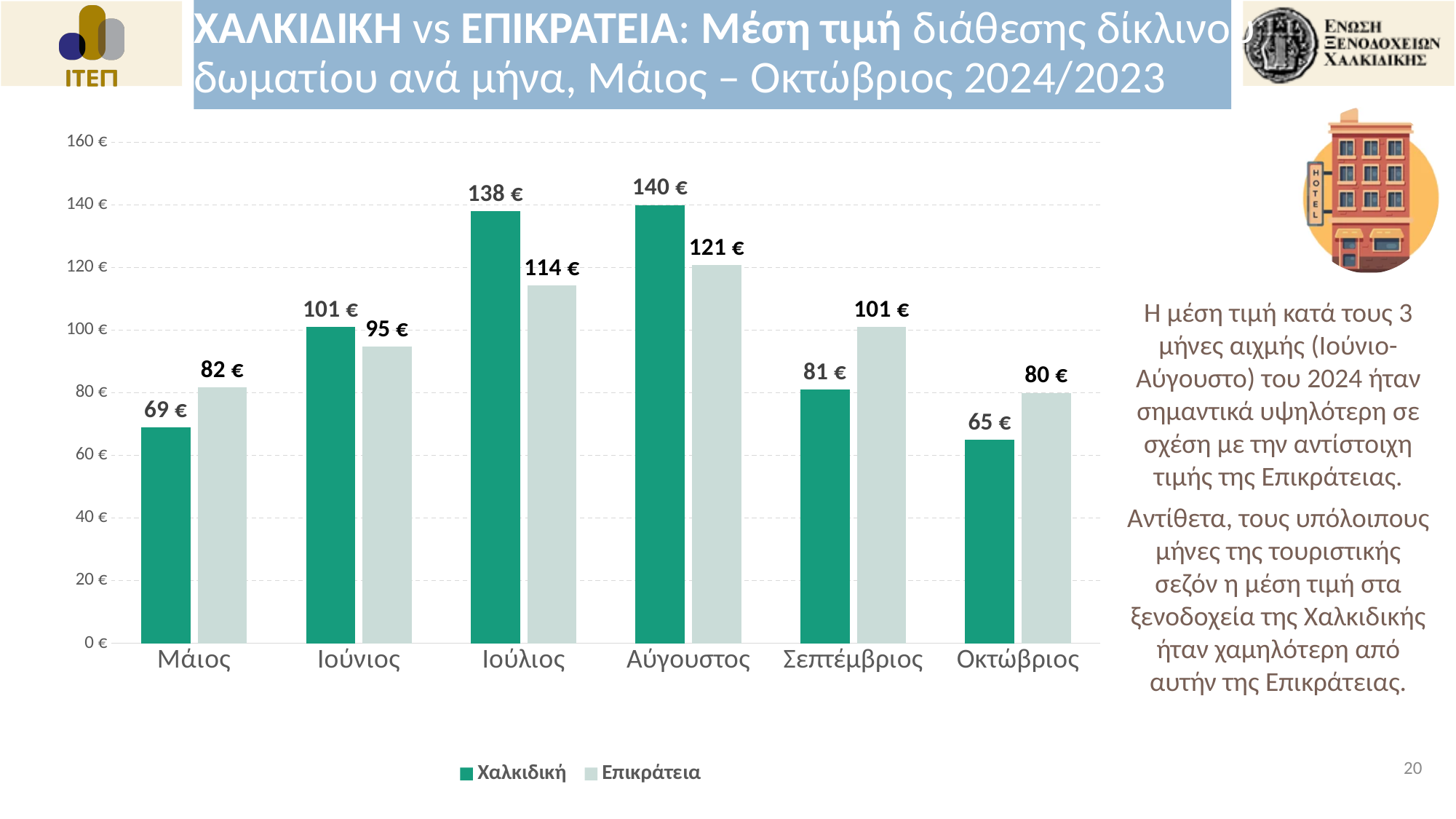
Which colour represents Χαλκιδική in the chart? green How many months are shown on the x axis? 6 Which month has the highest value for Χαλκιδική? Αύγουστος Which month has the lowest value for Επικράτεια? Οκτώβριος Is the value for Επικράτεια in Αύγουστος greater or less than 100 €? greater How many series does the legend list? 2 In Σεπτέμβριος, which is larger: Χαλκιδική or Επικράτεια? Επικράτεια What is the value for Χαλκιδική in Μάιος? 69 € What is the value for Επικράτεια in Σεπτέμβριος? 101 € What kind of chart is shown on the slide? bar chart What is the value for Χαλκιδική in Ιούλιος? 138 € What is the difference between Χαλκιδική and Επικράτεια in Ιούλιος? 24 €